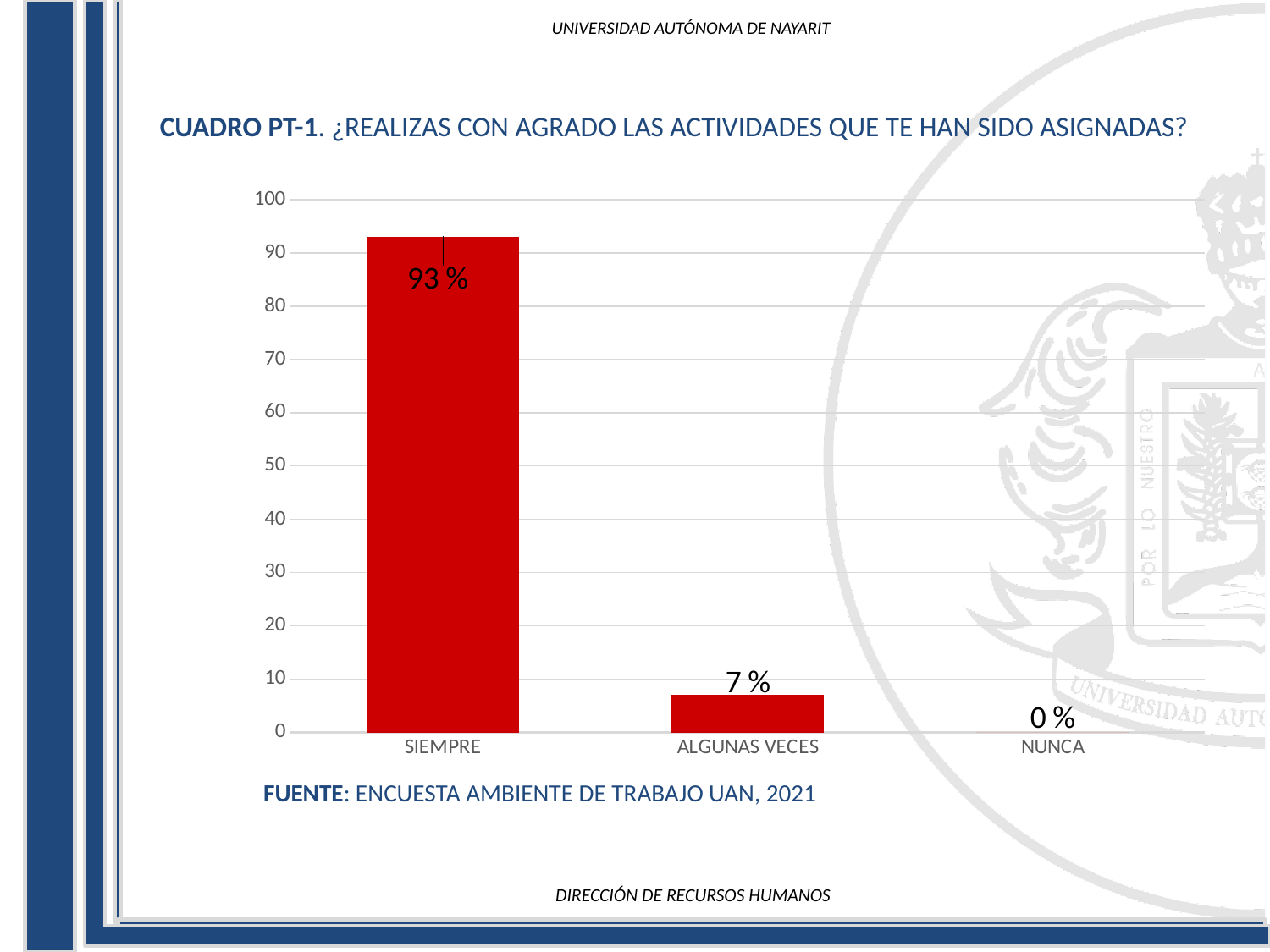
What is the value for ALGUNAS VECES? 7 % Is the value for ALGUNAS VECES greater or less than 10? less Which category has the lowest value? NUNCA What source is cited below the chart? ENCUESTA AMBIENTE DE TRABAJO UAN, 2021 How many categories are shown on the x axis? 3 What kind of chart is shown on the slide? bar chart Which category has the highest value? SIEMPRE What is the difference between the values for SIEMPRE and ALGUNAS VECES? 86 % What is the value for NUNCA? 0 % Is the value for SIEMPRE greater or less than 80? greater Which is larger, the value for ALGUNAS VECES or the value for NUNCA? ALGUNAS VECES What is the value for SIEMPRE? 93 %